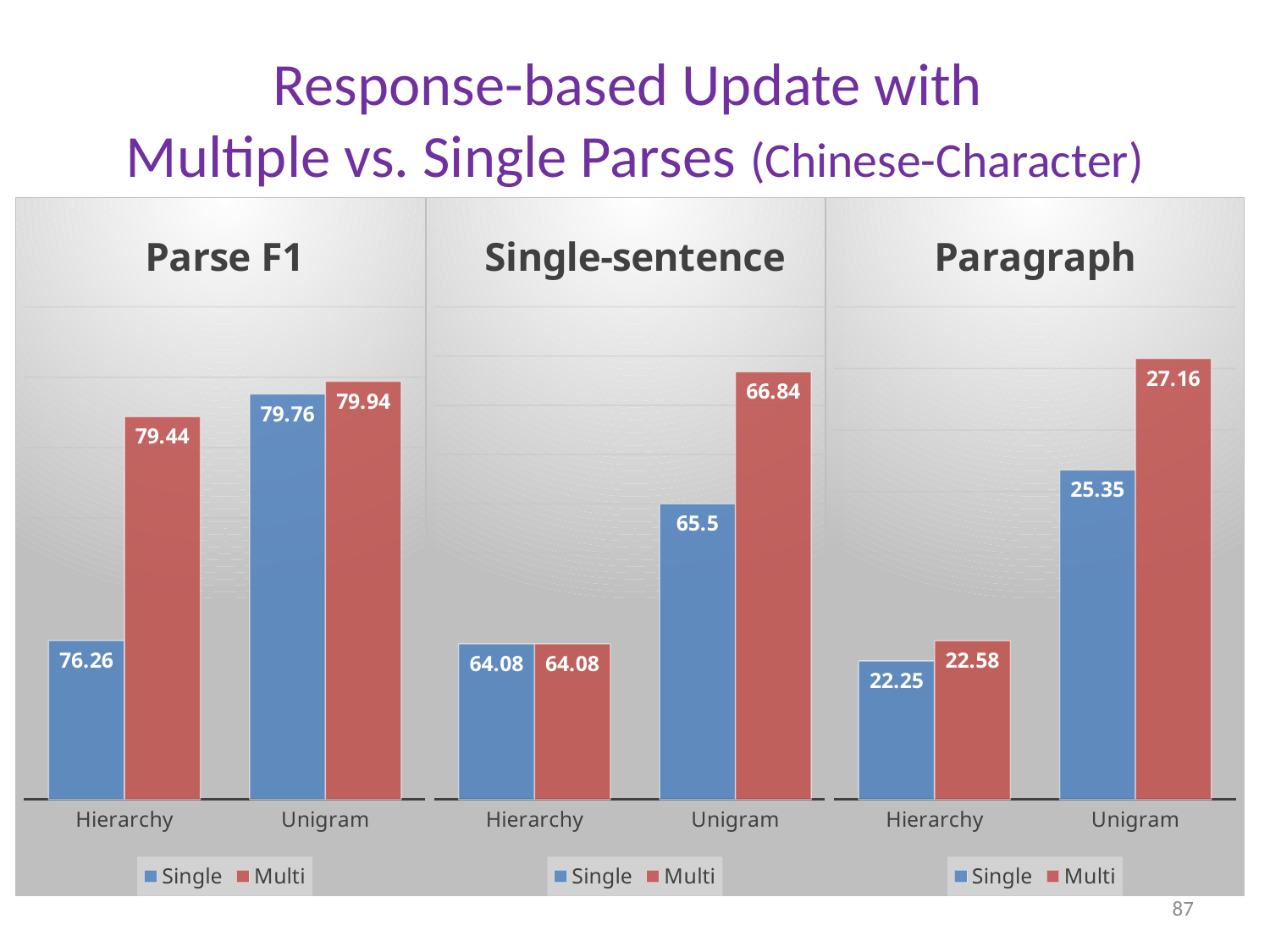
How many categories are shown on the x axis of the Single-sentence chart? 2 What kind of chart is the Parse F1 chart? bar chart How many series does the legend of the Paragraph chart list? 2 In the Parse F1 chart, what is the difference between the Multi and Single values under Hierarchy? 3.18 In the Parse F1 chart, which bar has the lowest value? Single under Hierarchy In the Single-sentence chart, what is the value for Single under Unigram? 65.5 In the Paragraph chart, what is the difference between the Multi and Single values under Unigram? 1.81 In the Parse F1 chart, what is the value for Multi under Hierarchy? 79.44 In the Single-sentence chart, is the Multi value under Unigram larger or smaller than the Single value under Unigram? larger In the Paragraph chart, what is the value for Multi under Unigram? 27.16 In the Paragraph chart, what is the value for Single under Hierarchy? 22.25 In the Single-sentence chart, which bar has the highest value? Multi under Unigram